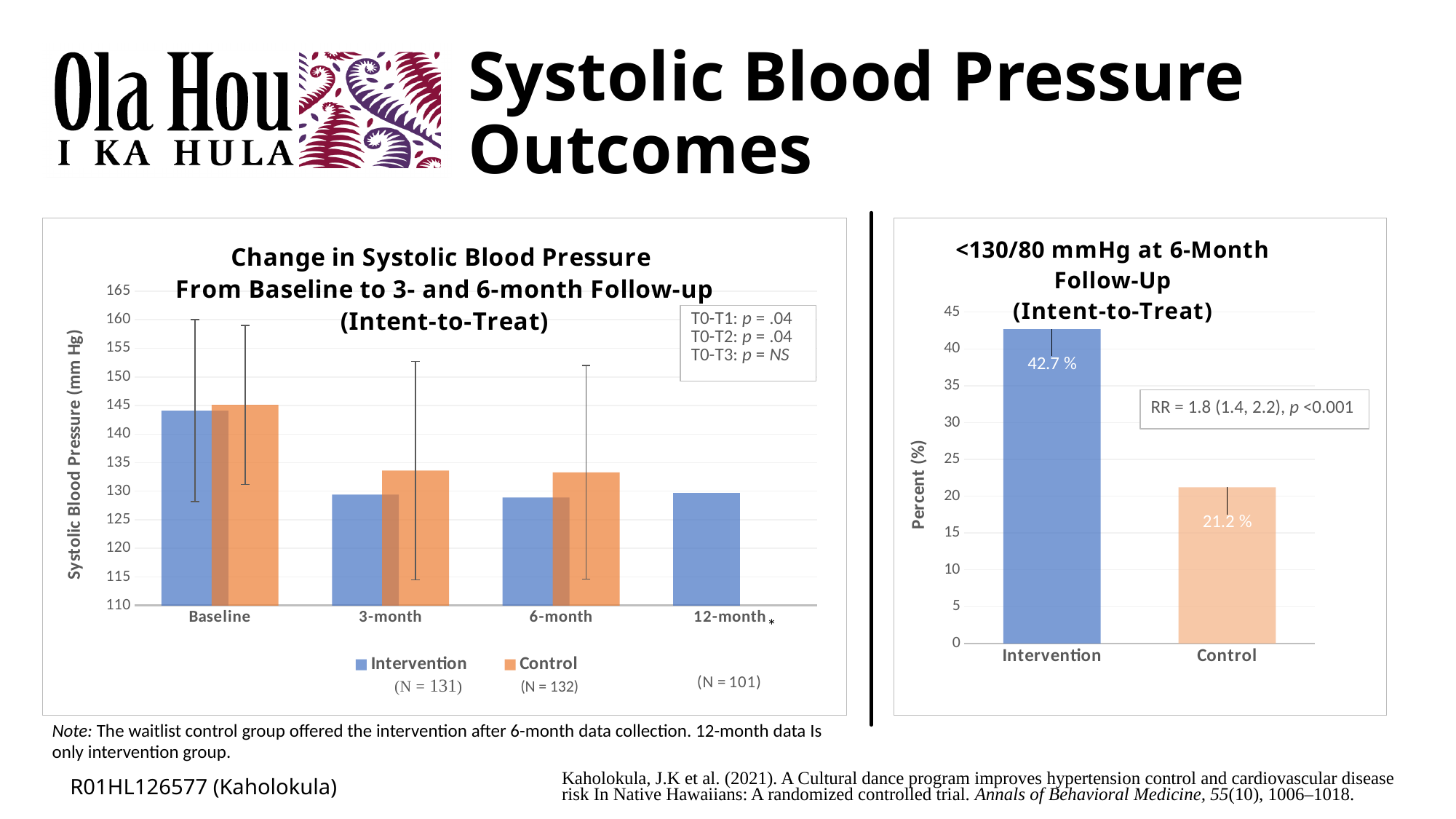
In the chart titled "<130/80 mmHg at 6-Month Follow-Up (Intent-to-Treat)", what is the value for Intervention? 42.7 % In the chart titled "<130/80 mmHg at 6-Month Follow-Up (Intent-to-Treat)", what is the difference between the Intervention and Control values? 21.5 % What kind of chart is the chart titled "Change in Systolic Blood Pressure From Baseline to 3- and 6-month Follow-up (Intent-to-Treat)"? Bar chart In the chart titled "Change in Systolic Blood Pressure From Baseline to 3- and 6-month Follow-up (Intent-to-Treat)", how many time-point categories are shown on the x axis? 4 In the chart titled "Change in Systolic Blood Pressure From Baseline to 3- and 6-month Follow-up (Intent-to-Treat)", is the Intervention value at 6-month greater or less than 135? less In the chart titled "Change in Systolic Blood Pressure From Baseline to 3- and 6-month Follow-up (Intent-to-Treat)", how many series does the legend list? 2 In the chart titled "<130/80 mmHg at 6-Month Follow-Up (Intent-to-Treat)", what is the value for Control? 21.2 % In the chart titled "<130/80 mmHg at 6-Month Follow-Up (Intent-to-Treat)", which group has the higher percentage? Intervention In the chart titled "<130/80 mmHg at 6-Month Follow-Up (Intent-to-Treat)", how many bars are plotted? 2 In the chart titled "Change in Systolic Blood Pressure From Baseline to 3- and 6-month Follow-up (Intent-to-Treat)", at which time point is the Control value highest? Baseline In the chart titled "Change in Systolic Blood Pressure From Baseline to 3- and 6-month Follow-up (Intent-to-Treat)", is the Intervention value at Baseline greater or less than 140? greater In the chart titled "Change in Systolic Blood Pressure From Baseline to 3- and 6-month Follow-up (Intent-to-Treat)", does the Intervention value rise or fall from Baseline to 3-month? Fall